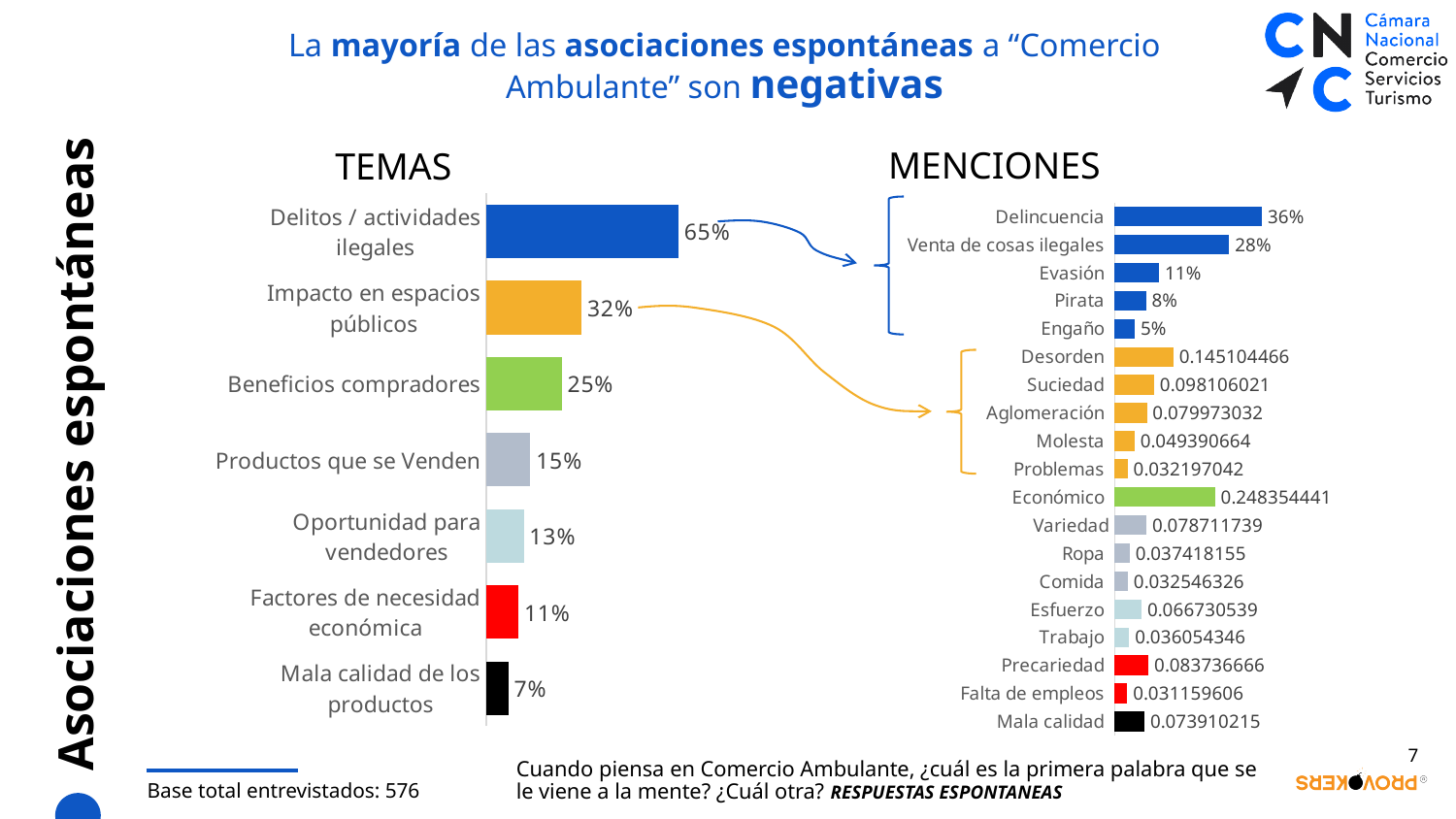
In the TEMAS chart, which category has the lowest value? Mala calidad de los productos In the TEMAS chart, what is the value for "Delitos / actividades ilegales"? 65% In the TEMAS chart, what is the difference between "Impacto en espacios públicos" and "Beneficios compradores"? 7% In the MENCIONES chart, what is the value for "Delincuencia"? 36% In the MENCIONES chart, what is the value for "Económico"? 0.248354441 In the MENCIONES chart, what is the value for "Precariedad"? 0.083736666 In the TEMAS chart, what is the value for "Productos que se Venden"? 15% In the TEMAS chart, how many categories are shown? 7 In the MENCIONES chart, which category has the highest value? Delincuencia In the MENCIONES chart, how many categories are shown? 19 In the MENCIONES chart, which is larger, "Evasión" or "Pirata"? Evasión What kind of chart is the TEMAS chart? Bar chart